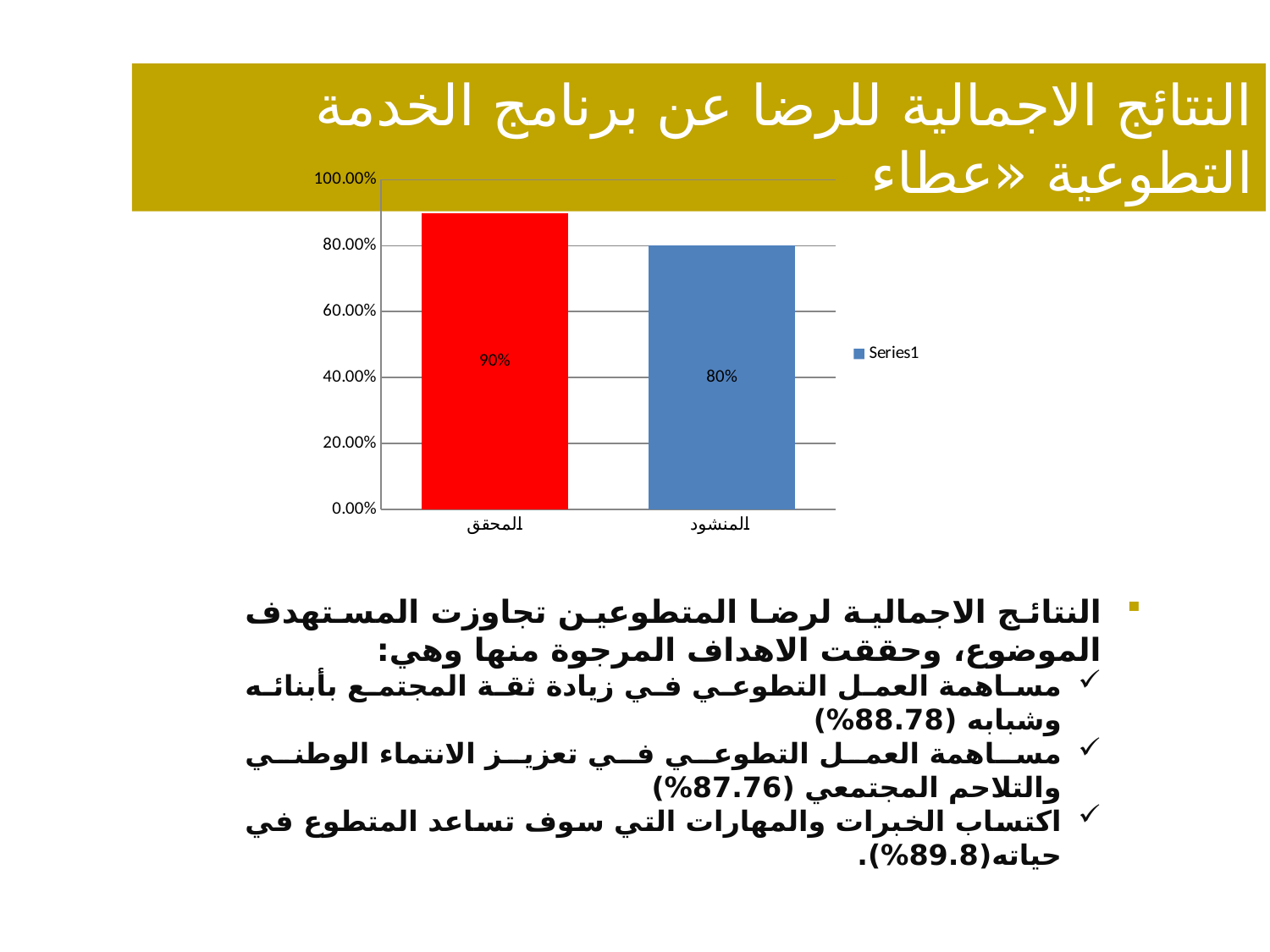
Which category has the highest value? المحقق Which is larger, the value for المحقق or the value for المنشود? المحقق What colour is the bar for المحقق? red How many series does the legend list? 1 Which category has the lowest value? المنشود What is the value for المحقق? 90% What is the name of the series listed in the legend? Series1 What is the difference between the values for المحقق and المنشود? 10% What kind of chart is shown on the slide? bar chart Is the value for المنشود greater or less than 60.00%? greater How many categories are shown on the chart? 2 What is the value for المنشود? 80%